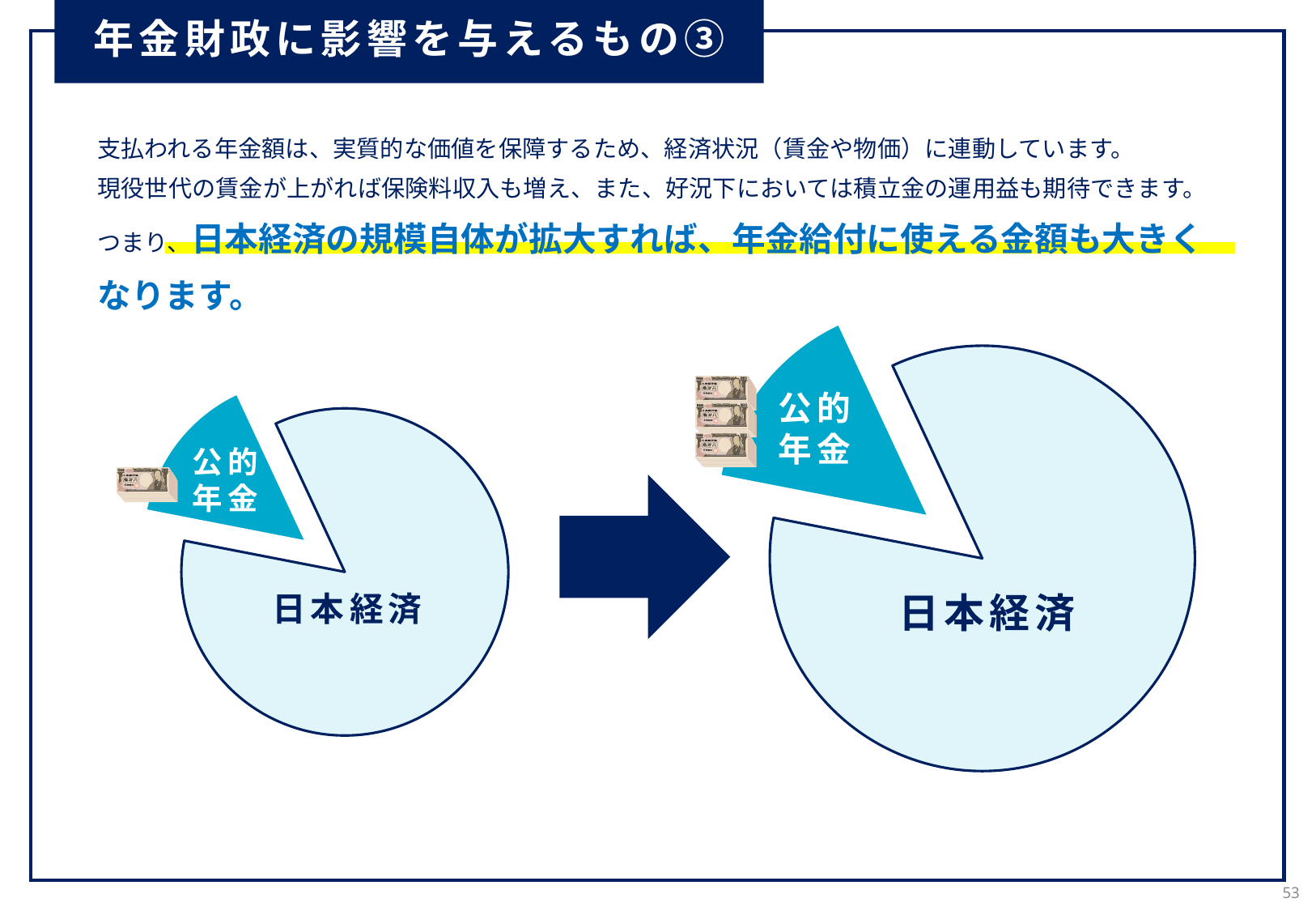
What kind of chart is shown on the left side of the slide? pie chart In the right pie chart, which slice is larger, 公的年金 or 日本経済? 日本経済 In the right pie chart, which slice is the largest? 日本経済 How many slices does the right pie chart have? 2 In the left pie chart, which slice is larger, 公的年金 or 日本経済? 日本経済 How many slices does the left pie chart have? 2 What kind of chart is shown on the right side of the slide? pie chart In the left pie chart, which slice is the smallest? 公的年金 What is the label of the pulled-out (exploded) slice in the left pie chart? 公的年金 Which of the two pie charts is drawn larger, the left one or the right one? the right one